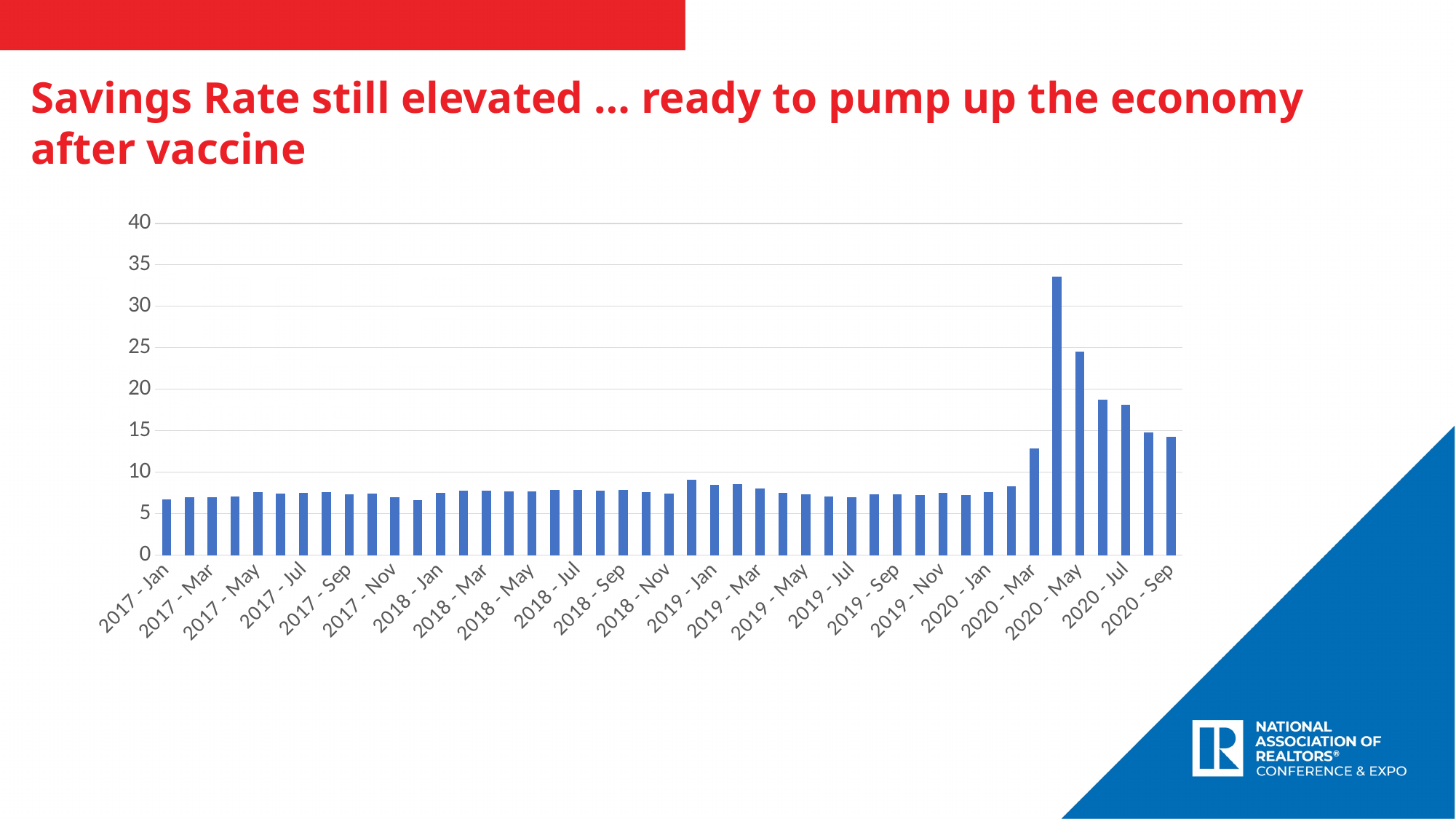
Is the value for 2017 - Jan greater or less than 10? less Which is larger, the value for 2020 - May or the value for 2020 - Sep? 2020 - May How many bars are plotted in the chart? 45 Is the value for 2020 - Mar greater or less than 10? greater Is the value for 2020 - Sep greater or less than 10? greater Do the values rise or fall from 2020 - May to 2020 - Sep? fall What is the highest value shown on the vertical axis? 40 What kind of chart is shown on the slide? bar chart What is the title of the slide containing the chart? Savings Rate still elevated … ready to pump up the economy after vaccine Which is larger, the value for 2019 - Mar or the value for 2020 - Mar? 2020 - Mar